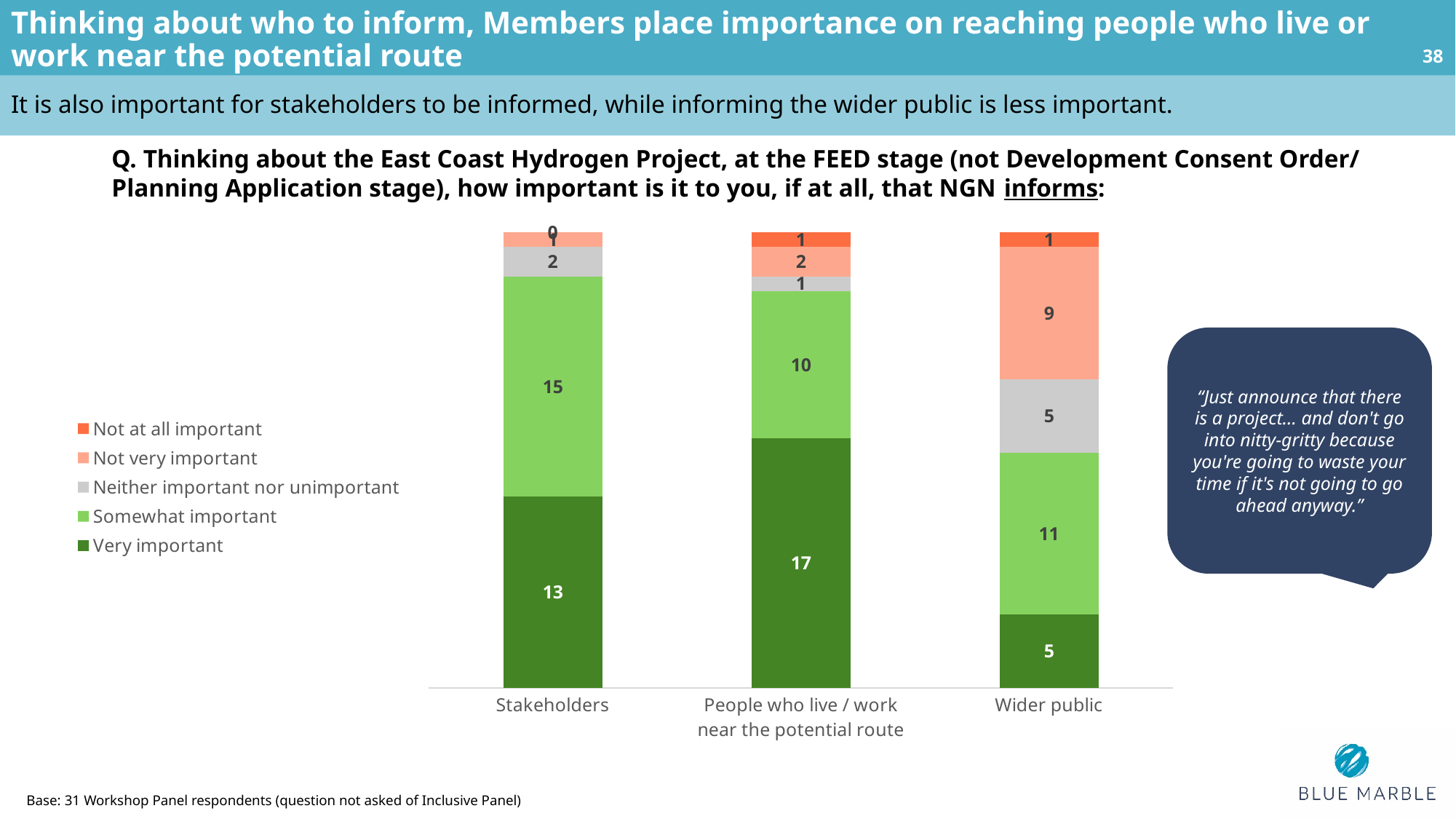
What kind of chart is shown on the slide? Stacked bar chart How many respondents rated informing people who live / work near the potential route as Very important? 17 What is the total of the stacked bar for Wider public? 31 How many series does the legend list? 5 How many categories are shown on the x axis of the chart? 3 Which has the larger Somewhat important value, Stakeholders or Wider public? Stakeholders Which category has the lowest Very important value? Wider public What is the Neither important nor unimportant value for Wider public? 5 What is the difference between the Very important values for People who live / work near the potential route and Stakeholders? 4 What is the Somewhat important value for Stakeholders? 15 What is the Not very important value for Wider public? 9 Which category has the highest Very important value? People who live / work near the potential route